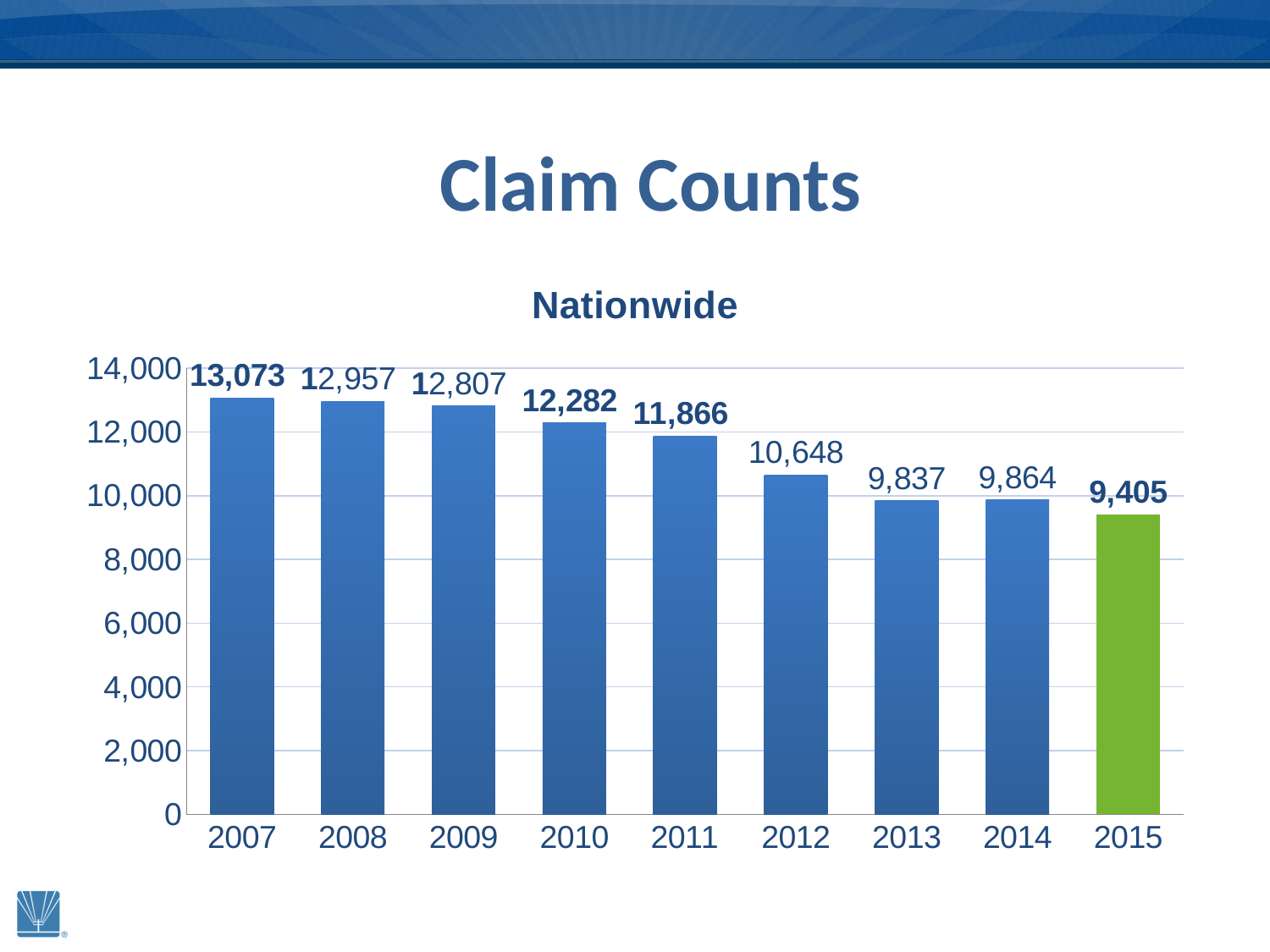
Which year has the lowest claim count? 2015 Is the claim count for 2014 greater or less than 10,000? less What is the difference between the claim counts for 2007 and 2015? 3,668 Which year's bar is coloured green rather than blue? 2015 How many years are shown on the chart? 9 What kind of chart is shown on the slide? bar chart What is the difference between the claim counts for 2011 and 2012? 1,218 What is the claim count for 2007? 13,073 Which year has the highest claim count? 2007 What is the claim count for 2012? 10,648 Which year has a larger claim count, 2010 or 2013? 2010 What is the claim count for 2015? 9,405